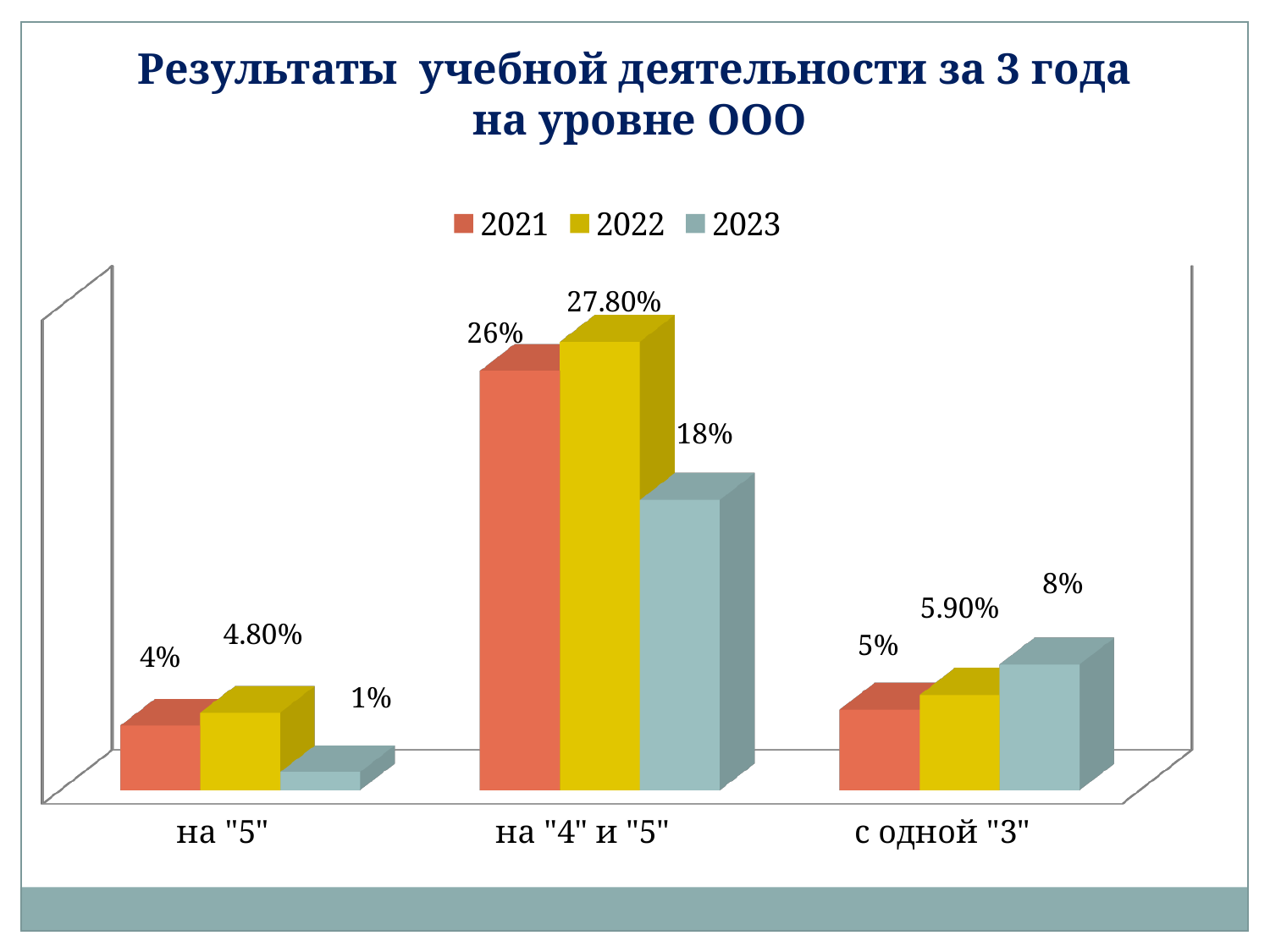
What kind of chart is shown on the slide? bar chart Which year has the highest value in the category на "4" и "5"? 2022 What is the difference between the 2022 and 2023 values in the category на "4" и "5"? 9.80% Which year has the lowest value in the category на "5"? 2023 Do the values in the category с одной "3" rise or fall from 2021 to 2023? rise Which year is shown in yellow in the legend? 2022 How many series does the legend list? 3 How many categories are shown on the x axis? 3 What is the value for 2021 in the category с одной "3"? 5% What is the value for 2022 in the category на "4" и "5"? 27.80% What is the value for 2023 in the category на "5"? 1% Which is larger: the 2023 value for с одной "3" or the 2023 value for на "5"? с одной "3"